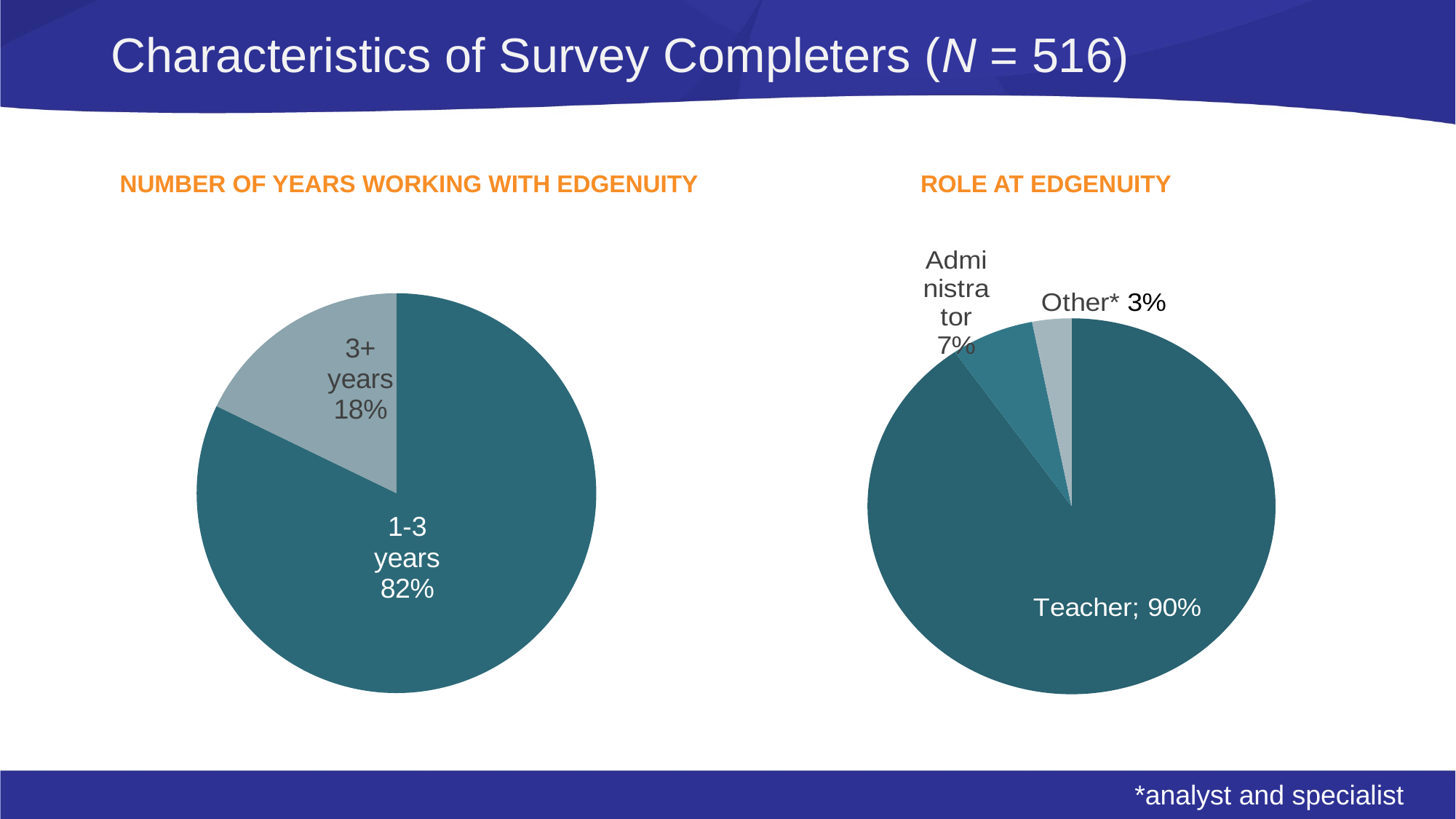
In the 'Number of Years Working with Edgenuity' chart, which category is larger: 1-3 years or 3+ years? 1-3 years In the 'Number of Years Working with Edgenuity' chart, what share of survey completers have worked 3+ years? 18% In the 'Role at Edgenuity' chart, what percentage of survey completers are teachers? 90% In the 'Role at Edgenuity' chart, which role has the smallest slice? Other* What type of chart is used for 'Number of Years Working with Edgenuity'? Pie chart In the 'Role at Edgenuity' chart, what percentage of survey completers are administrators? 7% In the 'Number of Years Working with Edgenuity' chart, what is the difference in percentage points between the 1-3 years and 3+ years slices? 64 In the 'Role at Edgenuity' chart, which role has the largest slice? Teacher How many slices does the 'Role at Edgenuity' chart have? 3 In the 'Role at Edgenuity' chart, what is the difference in percentage points between the Teacher and Administrator slices? 83